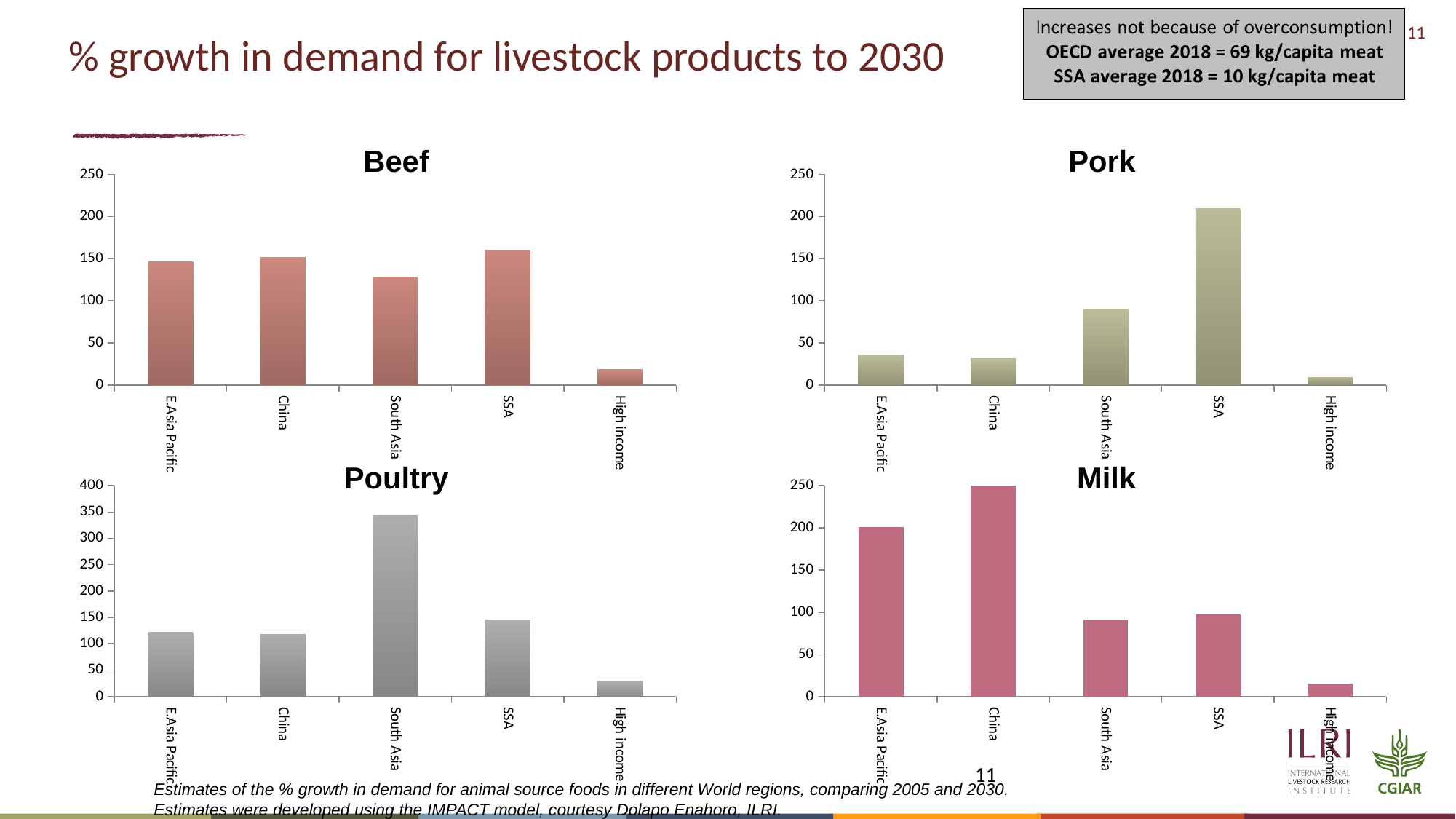
In the Beef chart, which region has the lowest % growth in demand? High income In the Poultry chart, which region has the highest % growth in demand? South Asia In the Milk chart, which region has the lowest % growth in demand? High income In the Beef chart, which region has the highest % growth in demand? SSA How many regions are shown in the Pork chart? 5 In the Beef chart, which is larger, the value for China or the value for South Asia? China In the Milk chart, which is larger, the value for E.Asia Pacific or the value for SSA? E.Asia Pacific What kind of chart is the Poultry chart? Bar chart In the Pork chart, is the value for SSA greater or less than 200? greater In the Milk chart, which region has the highest % growth in demand? China In the Poultry chart, is the value for South Asia greater or less than 300? greater